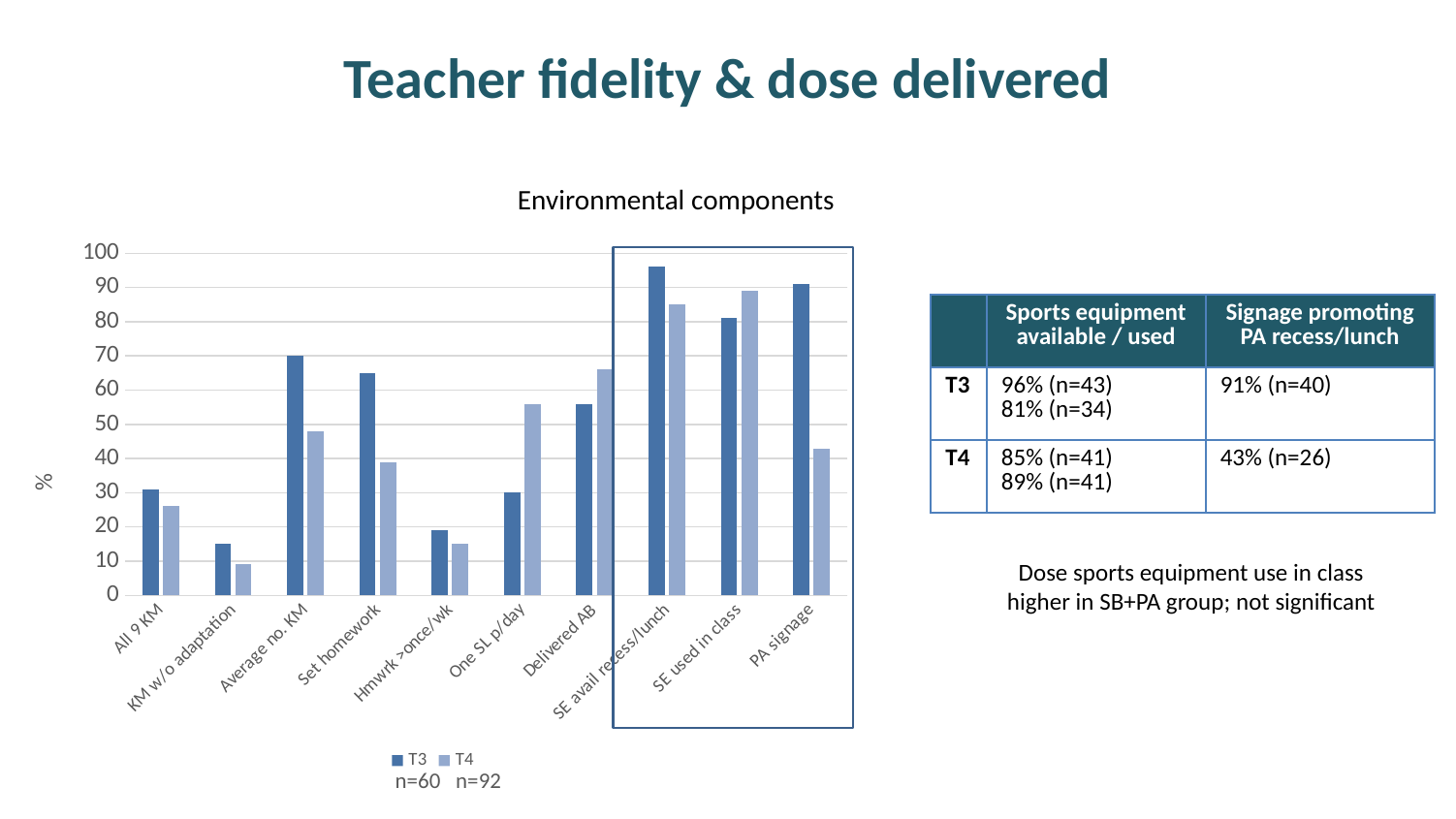
Is the T3 value for Set homework greater or less than 60? greater Which category has the highest T3 value in the chart? SE avail recess/lunch What is the T3 value for Average no. KM? 70 Which two series are listed in the chart legend? T3 and T4 How many categories are shown along the x axis of the chart? 10 How many series does the chart legend list? 2 What kind of chart is shown on the slide? Bar chart What is the title of the chart? Environmental components Which category has the lowest T4 value in the chart? KM w/o adaptation Is the T3 value for All 9 KM greater or less than 40? less What is the difference between the T3 and T4 values for PA signage? 48 For One SL p/day, which series has the larger value, T3 or T4? T4